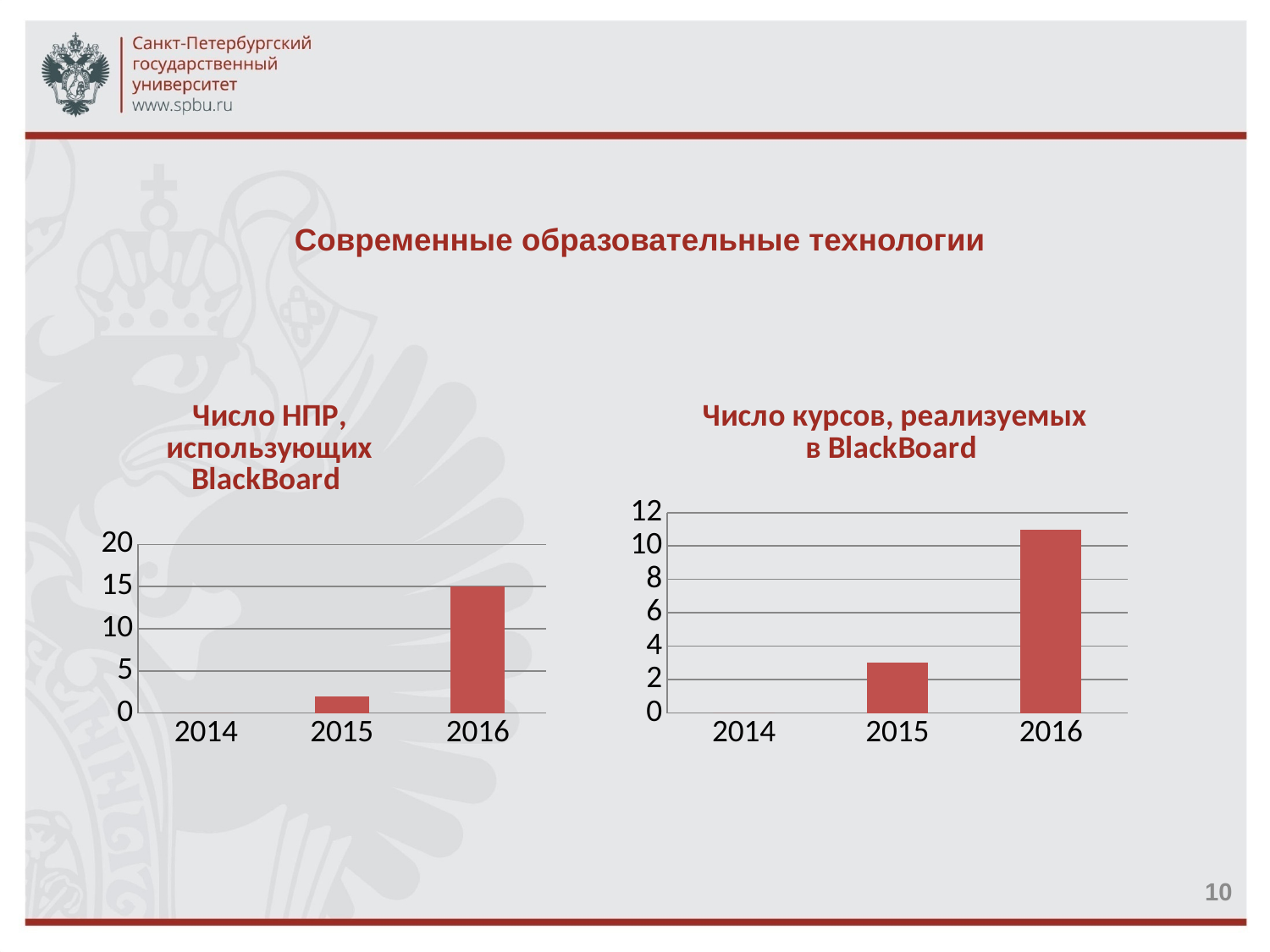
How many years are shown on the x axis of the chart "Число НПР, использующих BlackBoard"? 3 What is the title of the right chart on the slide? Число курсов, реализуемых в BlackBoard In the chart "Число курсов, реализуемых в BlackBoard", do the values rise or fall from 2014 to 2016? rise In the chart "Число курсов, реализуемых в BlackBoard", which year has the larger value, 2015 or 2016? 2016 In the chart "Число курсов, реализуемых в BlackBoard", is the value for 2015 greater or less than 4? less In the chart "Число НПР, использующих BlackBoard", is the value for 2015 greater or less than 5? less In the chart "Число курсов, реализуемых в BlackBoard", which year has the highest value? 2016 In the chart "Число НПР, использующих BlackBoard", do the values rise or fall from 2014 to 2016? rise In the chart "Число НПР, использующих BlackBoard", which year has the highest value? 2016 In the chart "Число НПР, использующих BlackBoard", what is the value for 2016? 15 What kind of chart is the left chart titled "Число НПР, использующих BlackBoard"? bar chart In the chart "Число курсов, реализуемых в BlackBoard", is the value for 2016 greater or less than 10? greater